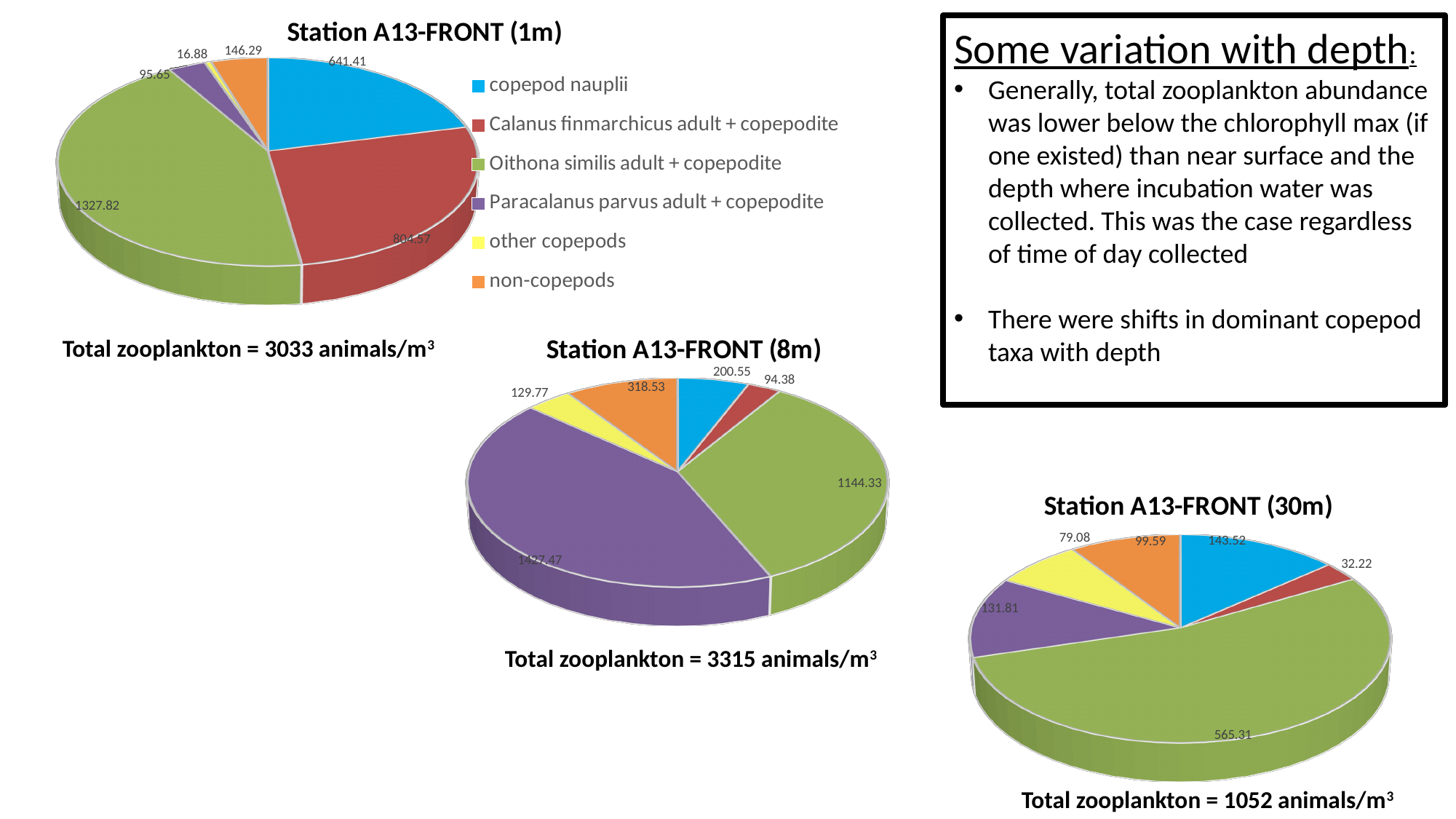
In the Station A13-FRONT (1m) chart, what is the value for Oithona similis adult + copepodite? 1327.82 In the Station A13-FRONT (8m) chart, which is larger: non-copepods or copepod nauplii? non-copepods In the Station A13-FRONT (1m) chart, which category has the smallest slice? other copepods In the Station A13-FRONT (8m) chart, which category has the largest slice? Paracalanus parvus adult + copepodite In the Station A13-FRONT (1m) chart, what is the difference between the Oithona similis and Calanus finmarchicus values? 523.25 In the Station A13-FRONT (30m) chart, which category has the largest slice? Oithona similis adult + copepodite In the Station A13-FRONT (30m) chart, what is the value for copepod nauplii? 143.52 How many categories does the legend list for the pie charts? 6 In the Station A13-FRONT (8m) chart, what is the value for Paracalanus parvus adult + copepodite? 1427.47 Which colour represents non-copepods in the pie charts? Orange What type of chart is used for Station A13-FRONT (8m)? Pie chart In the Station A13-FRONT (30m) chart, which is larger: Paracalanus parvus adult + copepodite or other copepods? Paracalanus parvus adult + copepodite